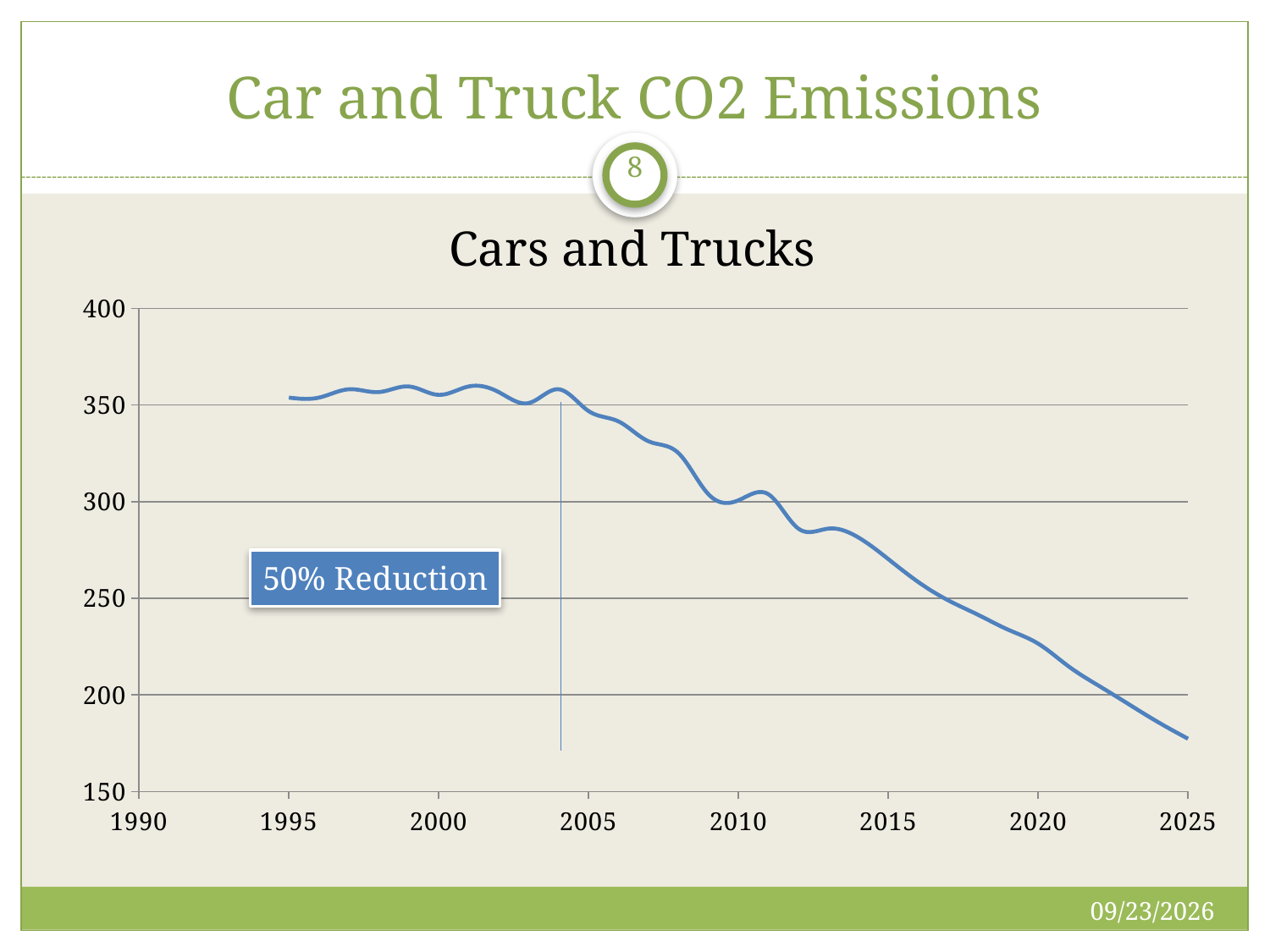
Is the value for 1995 greater or less than 300? greater Is the value for 2020 greater or less than 250? less What kind of chart is shown on the slide? line chart Is the value for 2005 greater or less than 300? greater Which year shown has the lowest value on the line? 2025 Do the values rise or fall along the x axis from 2005 to 2025? fall Which is larger, the value for 2005 or the value for 2015? 2005 What is the title of the chart? Cars and Trucks What does the text box on the chart say? 50% Reduction